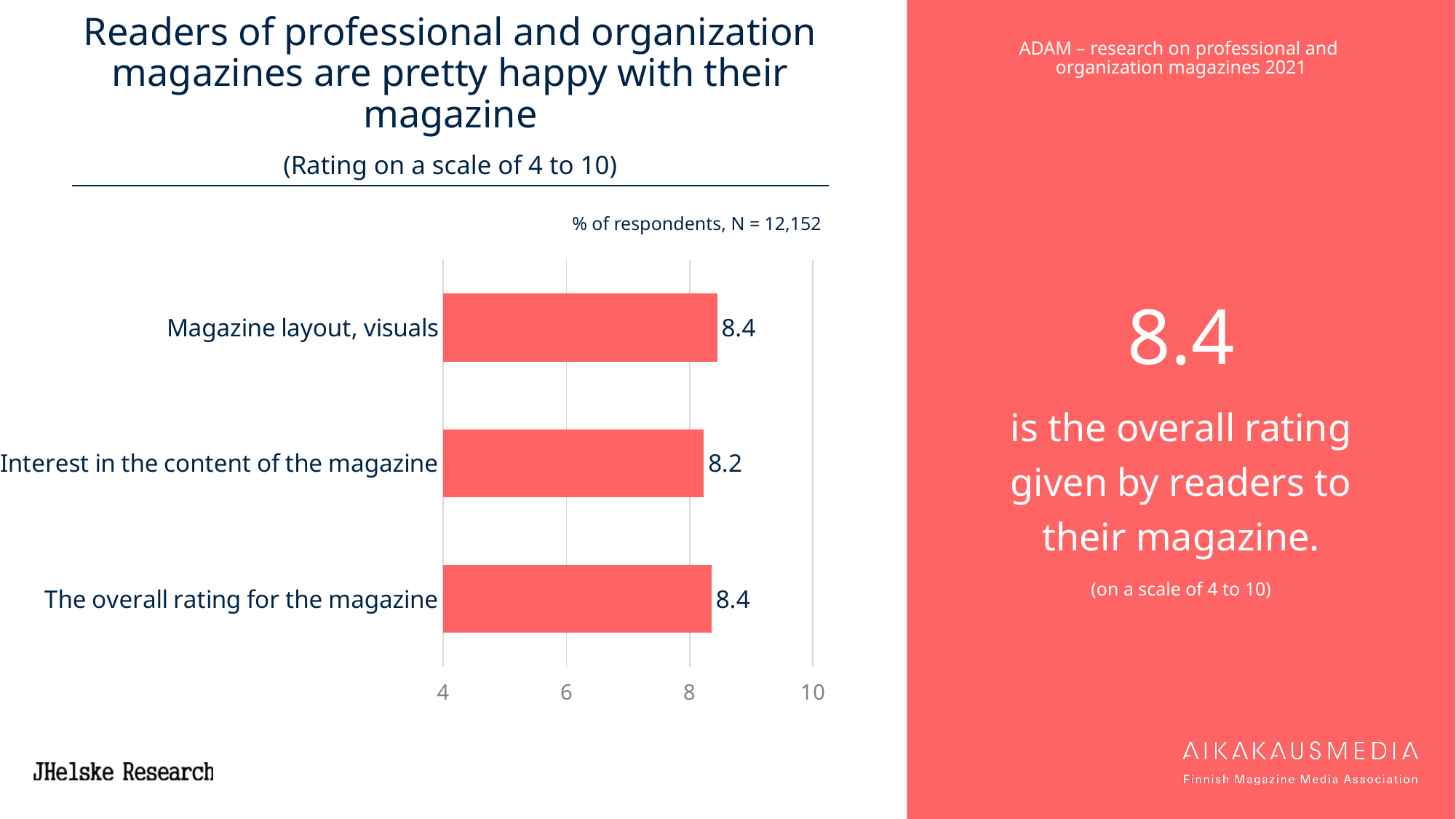
Which category has the lowest rating? Interest in the content of the magazine What is the rating for Magazine layout, visuals? 8.4 What kind of chart is shown on the slide? Bar chart What rating scale is stated in the chart subtitle? 4 to 10 What is the rating for The overall rating for the magazine? 8.4 What is the rating for Interest in the content of the magazine? 8.2 How many categories are shown in the chart? 3 What is the number of respondents (N) stated above the chart? 12,152 Is the value for Interest in the content of the magazine greater or less than 8? greater What is the difference between the rating for Magazine layout, visuals and the rating for Interest in the content of the magazine? 0.2 Is the value for The overall rating for the magazine greater or less than 10? less Which is larger: the rating for Magazine layout, visuals or the rating for Interest in the content of the magazine? Magazine layout, visuals